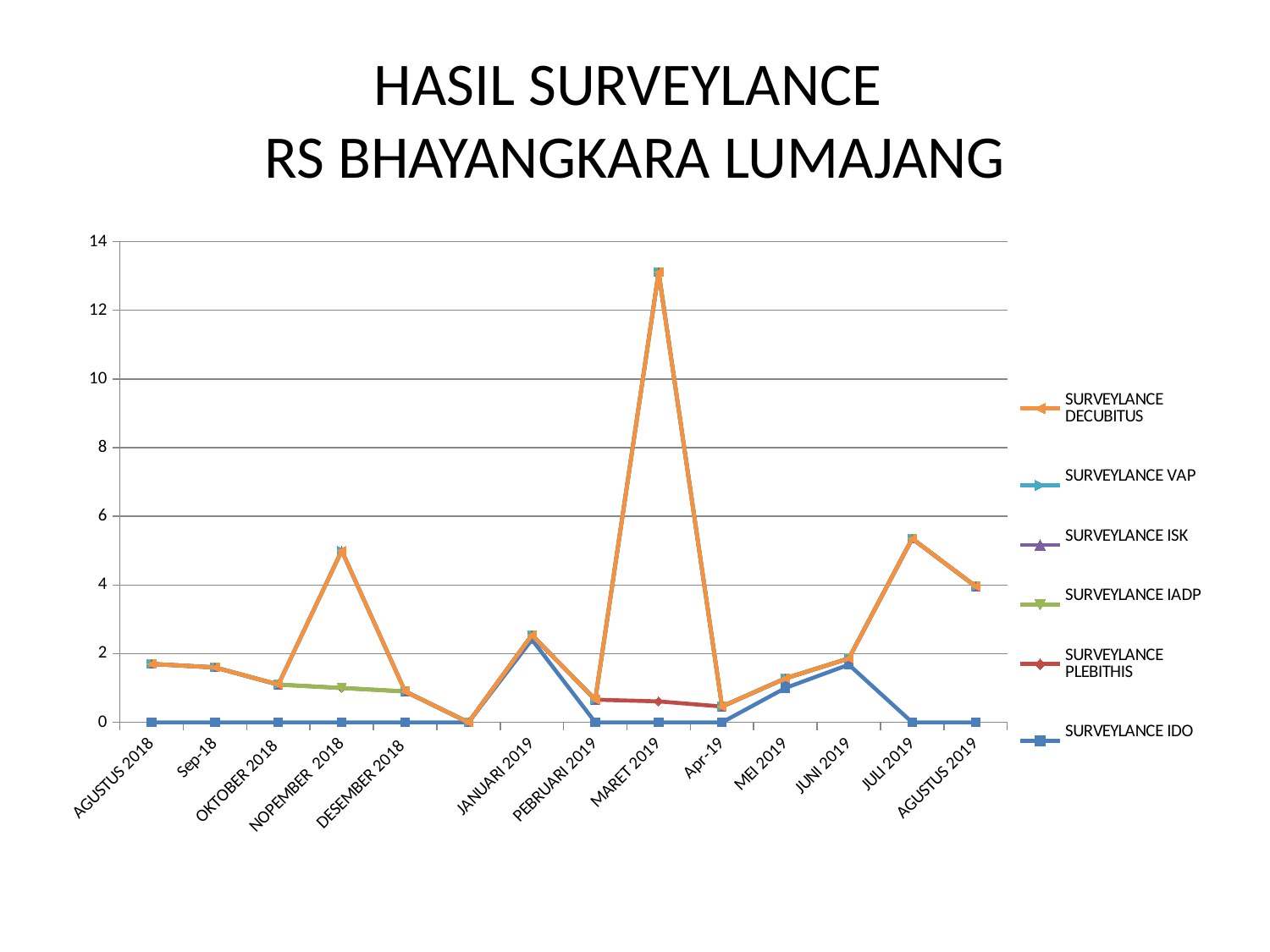
Which is larger for SURVEYLANCE DECUBITUS: the value in MARET 2019 or the value in JULI 2019? MARET 2019 How many series does the legend list? 6 Is the value for SURVEYLANCE DECUBITUS in AGUSTUS 2019 greater or less than 6? less Is the value for SURVEYLANCE DECUBITUS in MARET 2019 greater or less than 12? greater Is the value for SURVEYLANCE IDO in JUNI 2019 greater or less than 1? greater What is the value for SURVEYLANCE IDO in JULI 2019? 0 What is the title of the slide? HASIL SURVEYLANCE RS BHAYANGKARA LUMAJANG Which series is drawn in orange in the legend? SURVEYLANCE DECUBITUS What kind of chart is shown on the slide? line chart Does SURVEYLANCE DECUBITUS rise or fall from JULI 2019 to AGUSTUS 2019? fall In which month does SURVEYLANCE DECUBITUS reach its highest value? MARET 2019